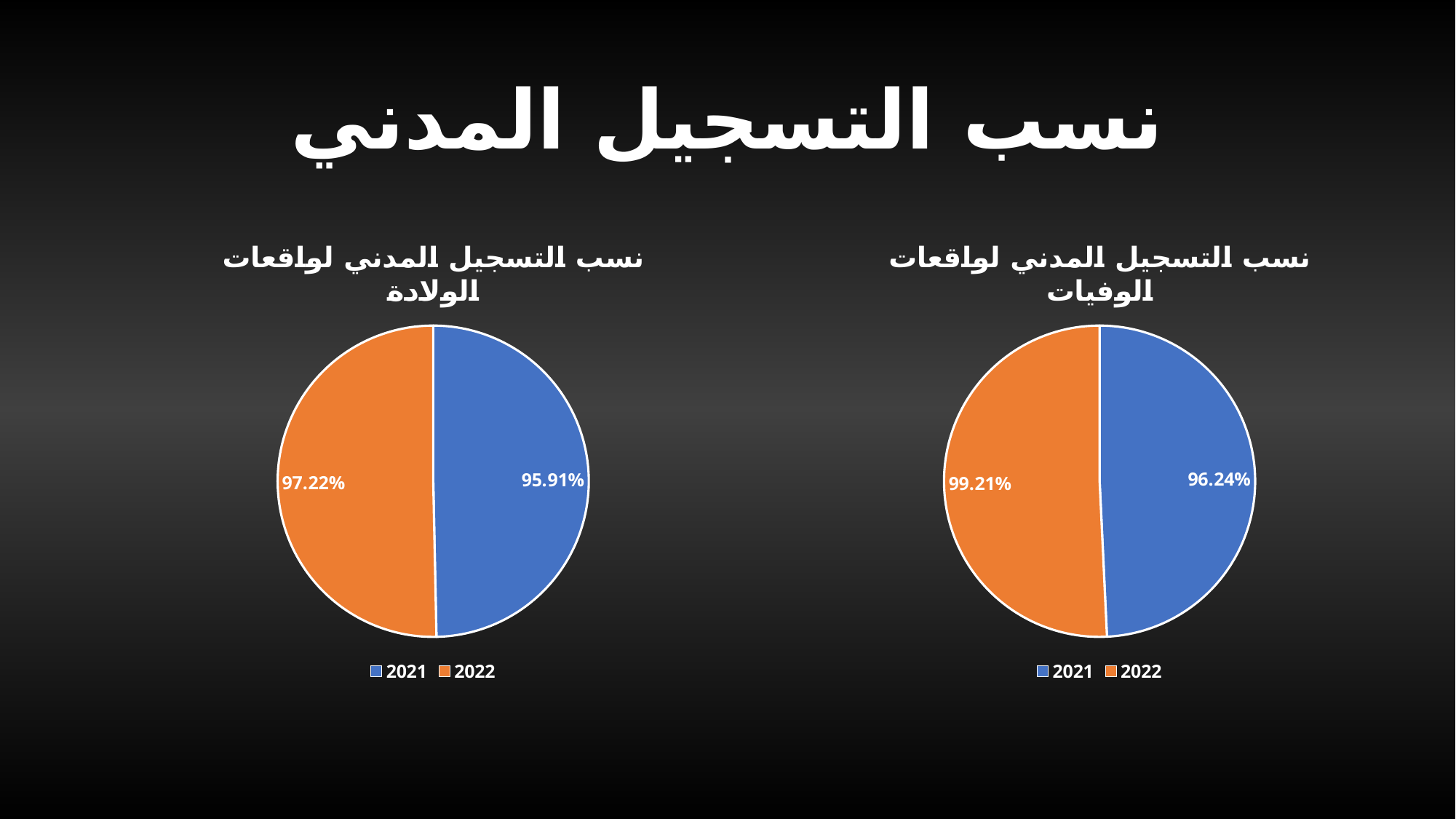
In the left chart (نسب التسجيل المدني لواقعات الولادة), what is the value for 2021? 95.91% What type of chart is the left chart? Pie chart In the right chart, what is the difference between the 2022 and 2021 values? 2.97% How many entries does the legend of the right chart list? 2 In the right chart, which year has the lower value? 2021 In the left chart, which year has the higher value? 2022 In the right chart (نسب التسجيل المدني لواقعات الوفيات), what is the value for 2022? 99.21% In the right chart, is the value for 2021 larger or smaller than the value for 2022? smaller In the left chart, which colour represents 2022? Orange In the left chart, what is the difference between the 2022 and 2021 values? 1.31% In the right chart (نسب التسجيل المدني لواقعات الوفيات), what is the value for 2021? 96.24% In the left chart (نسب التسجيل المدني لواقعات الولادة), what is the value for 2022? 97.22%